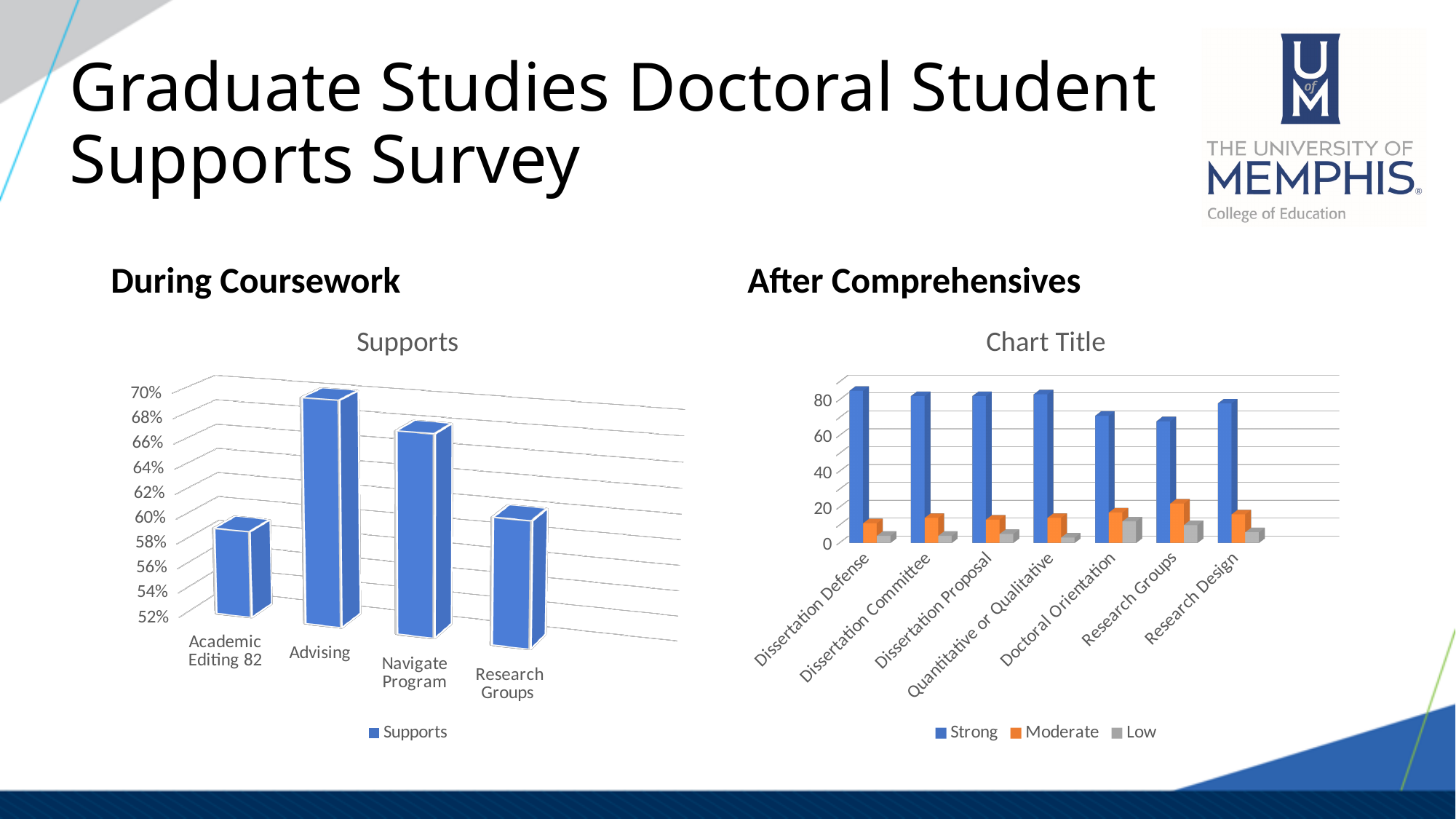
On the 'Supports' chart under 'During Coursework', is the value for Academic Editing 82 greater or less than 62%? less On the 'Supports' chart under 'During Coursework', is the value for Navigate Program greater or less than 62%? greater How many categories are shown on the 'Supports' chart under 'During Coursework'? 4 On the 'Chart Title' chart under 'After Comprehensives', which category has the highest Moderate value? Research Groups What kind of chart is the 'Supports' chart under 'During Coursework'? bar chart How many series does the legend list on the 'Chart Title' chart under 'After Comprehensives'? 3 On the 'Supports' chart under 'During Coursework', which is larger: the value for Navigate Program or the value for Research Groups? Navigate Program What are the legend entries on the 'Chart Title' chart under 'After Comprehensives'? Strong, Moderate, Low On the 'Supports' chart under 'During Coursework', which category has the lowest value? Academic Editing 82 On the 'Chart Title' chart under 'After Comprehensives', is the Strong value for Dissertation Defense greater or less than 60? greater How many categories are shown on the 'Chart Title' chart under 'After Comprehensives'? 7 On the 'Supports' chart under 'During Coursework', which category has the highest value? Advising